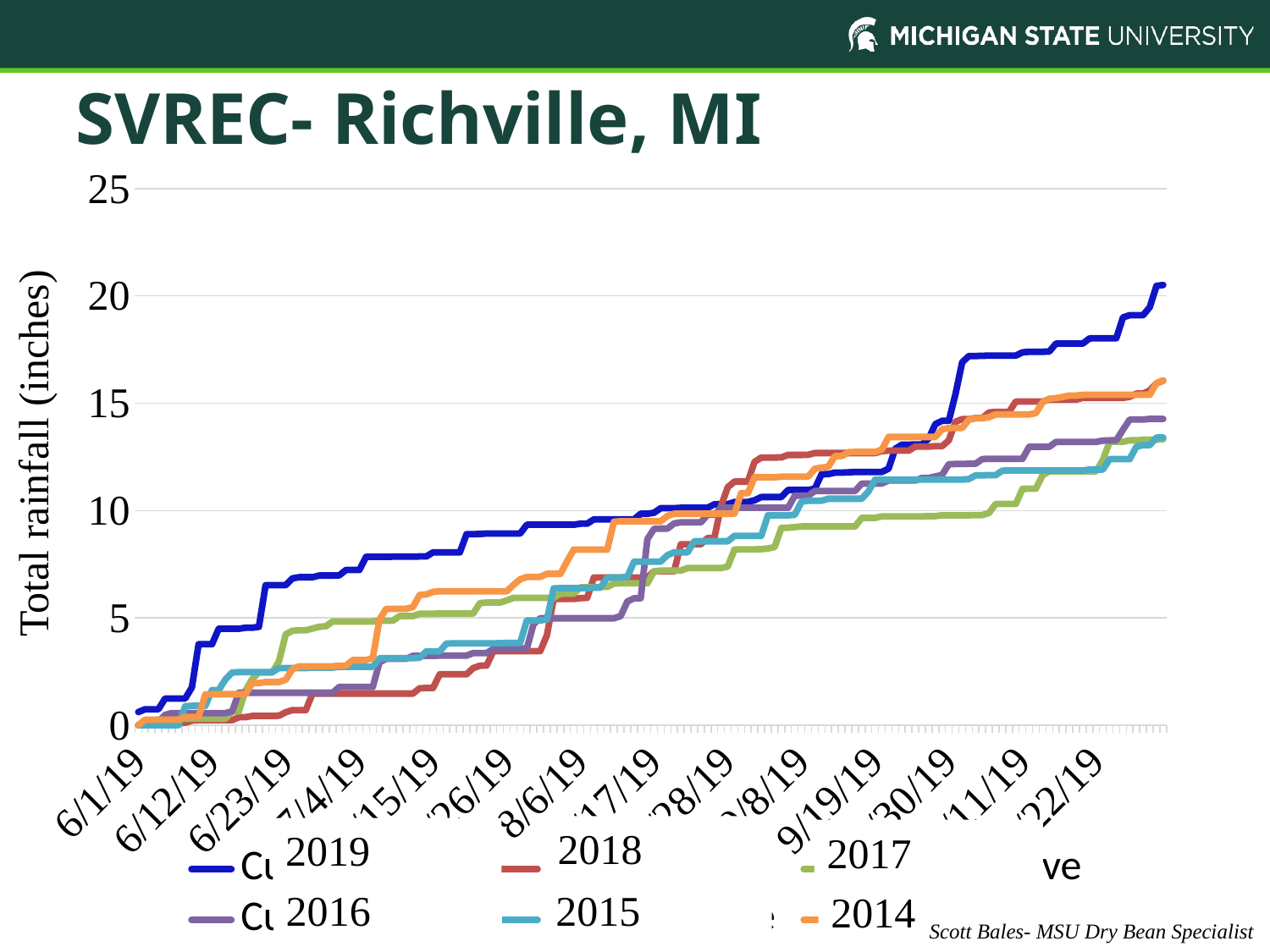
Which year's line reaches the highest total rainfall at the end of the chart? 2019 Is the final value of the 2014 line greater or less than 15? greater Is the final value of the 2019 line greater or less than 20? greater At the right end of the chart, which line is higher: 2019 or 2017? 2019 What is the title of the chart? SVREC- Richville, MI Is the final value of the 2017 line greater or less than 15? less At the right end of the chart, which line is higher: 2014 or 2016? 2014 What kind of chart is shown on the slide? line chart What is the highest tick value shown on the vertical axis? 25 Do the lines generally rise or fall from left to right along the x axis? rise What is the label on the vertical axis of the chart? Total rainfall (inches)